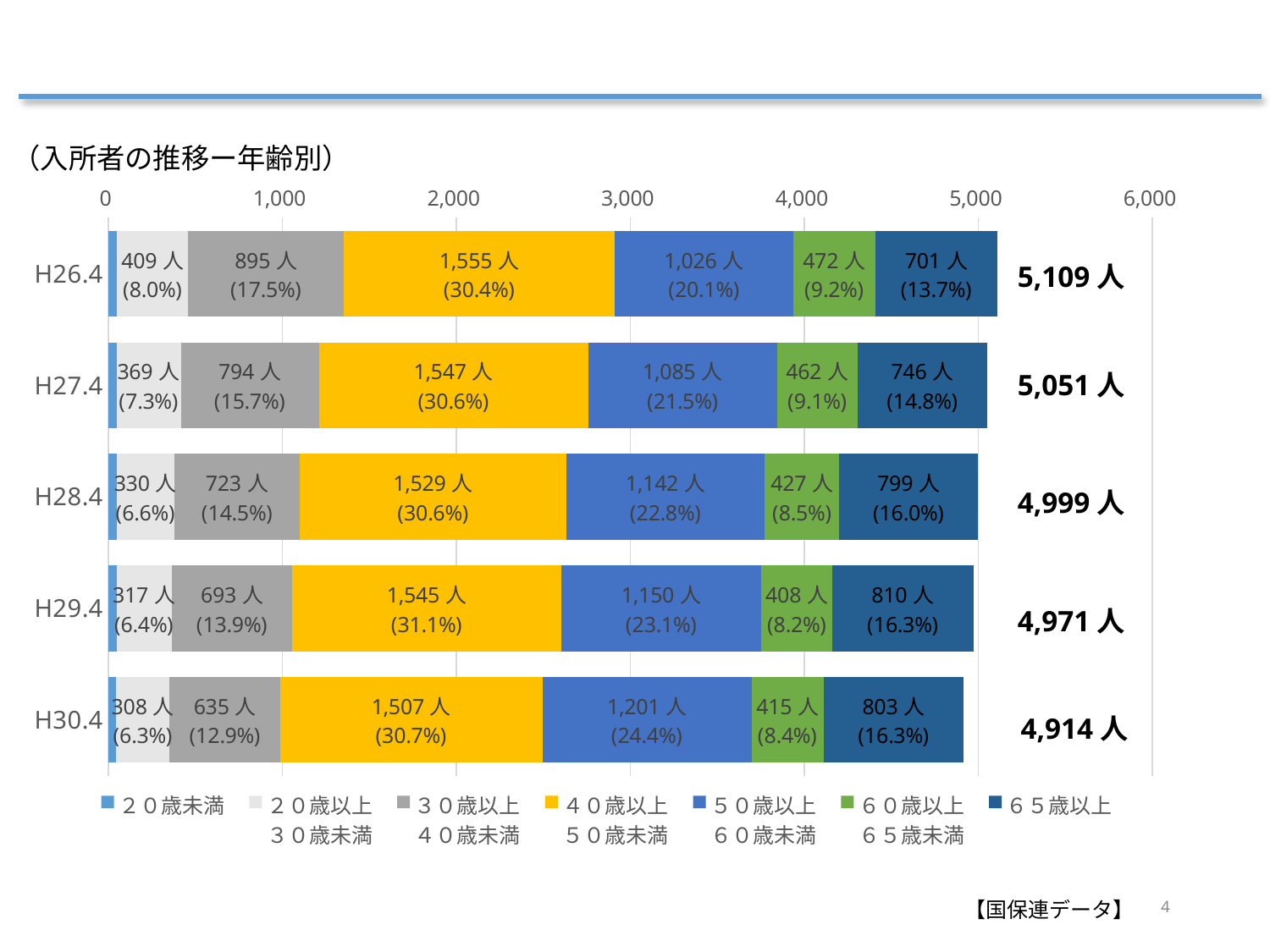
Do the totals rise or fall from H26.4 to H30.4? Fall Which year has the lowest total number of 入所者? H30.4 Which year has the highest total number of 入所者? H26.4 What kind of chart is shown on the slide? Stacked bar chart What is the value for 65歳以上 in H30.4? 803 人 (16.3%) What is the total for H28.4? 4,999 人 What is the difference between the totals for H26.4 and H30.4? 195 人 How many year categories are plotted on the chart? 5 What is the title of the chart? （入所者の推移ー年齢別） How many series does the legend list? 7 Which is larger, the 50歳以上60歳未満 value in H30.4 or in H26.4? H30.4 (1,201 人) What is the value for 40歳以上50歳未満 in H26.4? 1,555 人 (30.4%)